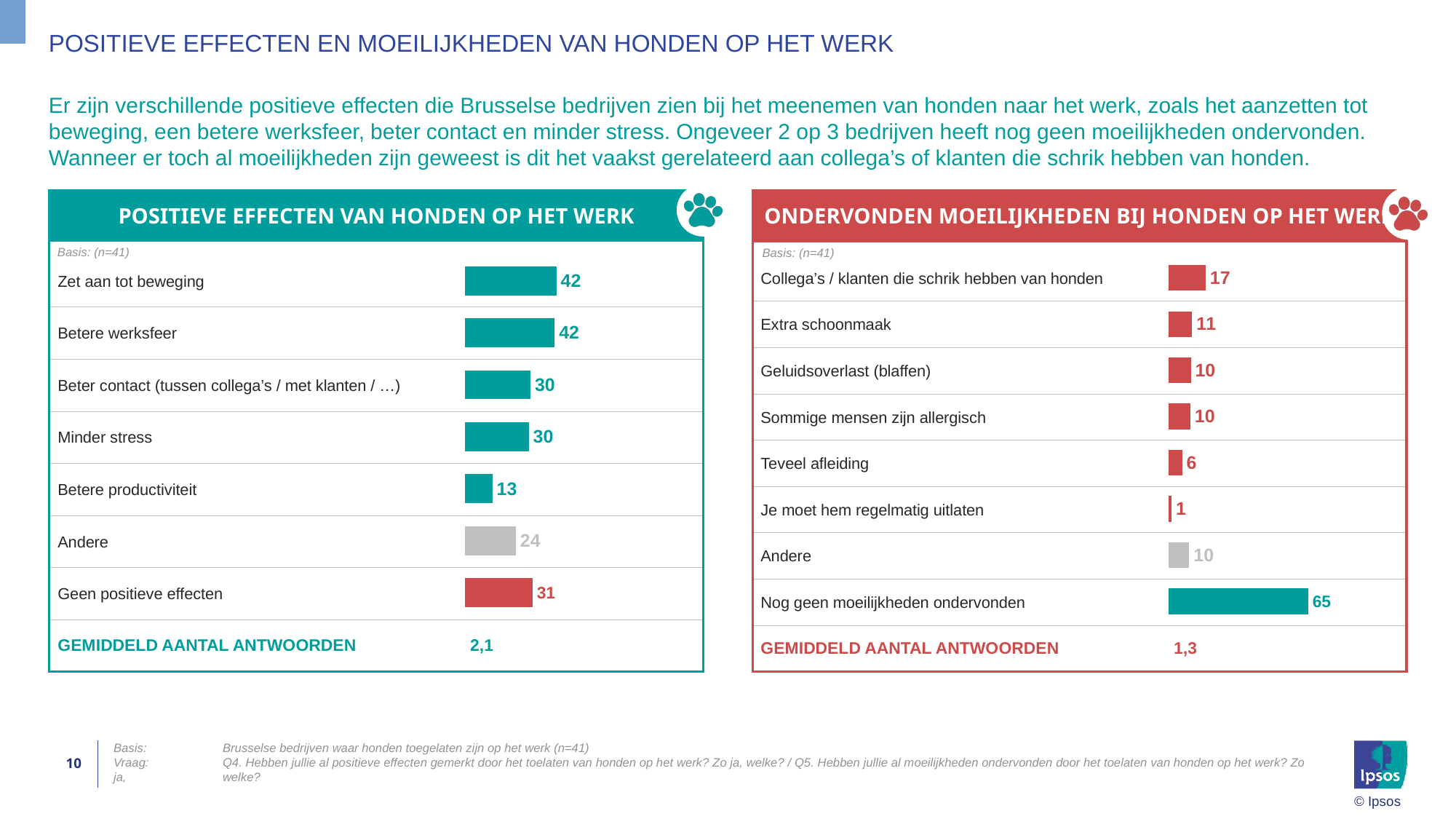
In the chart 'POSITIEVE EFFECTEN VAN HONDEN OP HET WERK', what is the difference between 'Zet aan tot beweging' and 'Betere productiviteit'? 29 In the chart 'ONDERVONDEN MOEILIJKHEDEN BIJ HONDEN OP HET WERK', which category has the highest value? Nog geen moeilijkheden ondervonden In the chart 'POSITIEVE EFFECTEN VAN HONDEN OP HET WERK', what is the value for 'Minder stress'? 30 In the chart 'ONDERVONDEN MOEILIJKHEDEN BIJ HONDEN OP HET WERK', what is the value for 'Extra schoonmaak'? 11 In the chart 'ONDERVONDEN MOEILIJKHEDEN BIJ HONDEN OP HET WERK', what is the difference between 'Nog geen moeilijkheden ondervonden' and 'Collega's / klanten die schrik hebben van honden'? 48 In the chart 'ONDERVONDEN MOEILIJKHEDEN BIJ HONDEN OP HET WERK', what is the 'GEMIDDELD AANTAL ANTWOORDEN'? 1,3 In the chart 'POSITIEVE EFFECTEN VAN HONDEN OP HET WERK', which category has the lowest value? Betere productiviteit In the chart 'ONDERVONDEN MOEILIJKHEDEN BIJ HONDEN OP HET WERK', which category has the lowest value? Je moet hem regelmatig uitlaten In the chart 'POSITIEVE EFFECTEN VAN HONDEN OP HET WERK', what is the value for 'Geen positieve effecten'? 31 What kind of chart is 'POSITIEVE EFFECTEN VAN HONDEN OP HET WERK'? Bar chart In the chart 'ONDERVONDEN MOEILIJKHEDEN BIJ HONDEN OP HET WERK', which is larger: 'Collega's / klanten die schrik hebben van honden' or 'Teveel afleiding'? Collega's / klanten die schrik hebben van honden In the chart 'POSITIEVE EFFECTEN VAN HONDEN OP HET WERK', how many categories are shown? 7